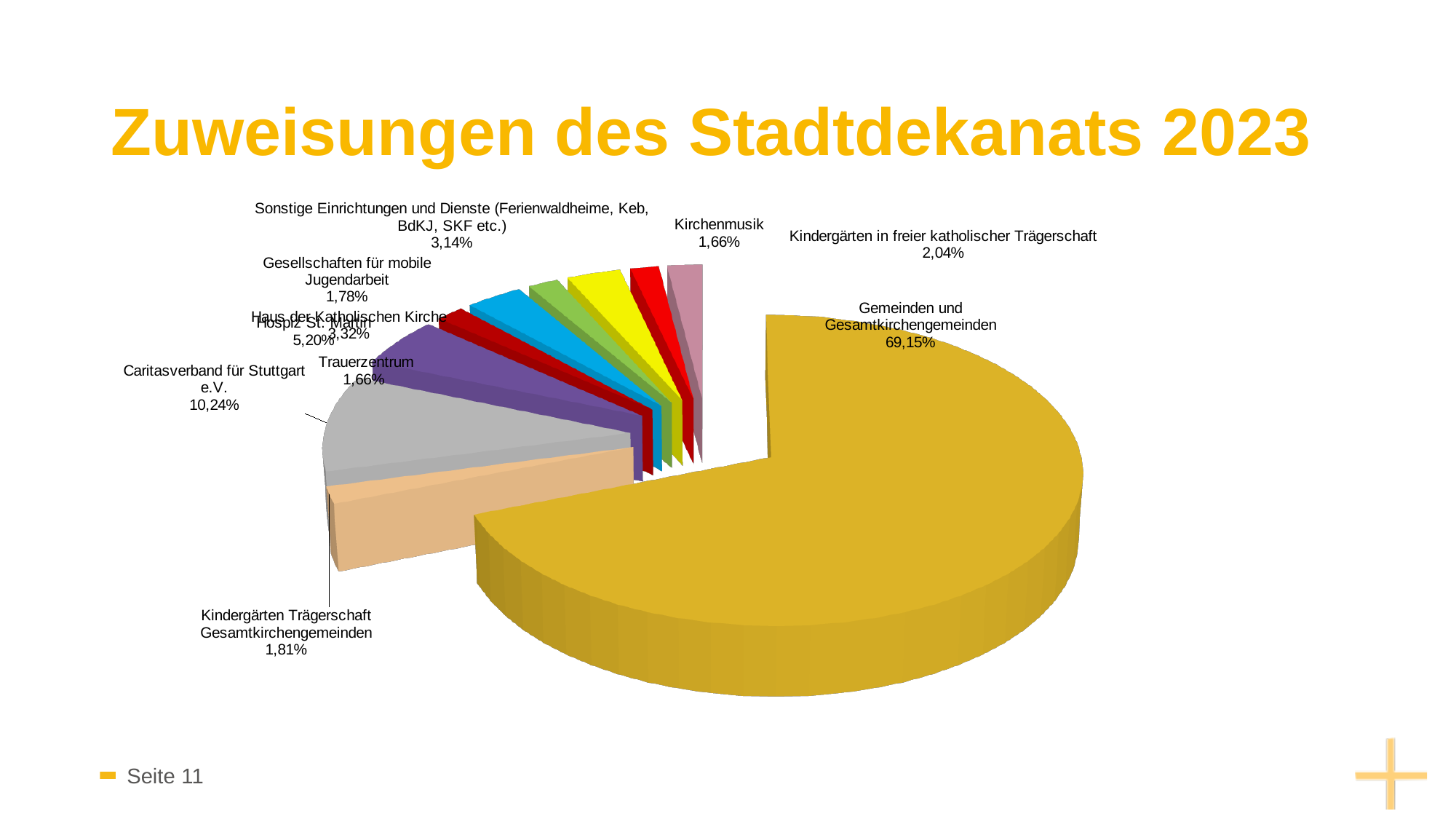
Which category has the largest share of the pie? Gemeinden und Gesamtkirchengemeinden Which has a larger share: Caritasverband für Stuttgart e.V. or Hospiz St. Martin? Caritasverband für Stuttgart e.V. What type of chart is shown on the slide? Pie chart How many slices does the pie chart have? 10 What is the difference in percentage points between Kindergärten in freier katholischer Trägerschaft and Kindergärten Trägerschaft Gesamtkirchengemeinden? 0,23% What percentage is shown for Sonstige Einrichtungen und Dienste (Ferienwaldheime, Keb, BdKJ, SKF etc.)? 3,14% What percentage is shown for Caritasverband für Stuttgart e.V.? 10,24% What is the difference in percentage points between Gemeinden und Gesamtkirchengemeinden and Caritasverband für Stuttgart e.V.? 58,91% What percentage is shown for Kindergärten in freier katholischer Trägerschaft? 2,04% What percentage is shown for Kirchenmusik? 1,66% What share of the pie does Gemeinden und Gesamtkirchengemeinden have? 69,15% What is the title of the chart? Zuweisungen des Stadtdekanats 2023